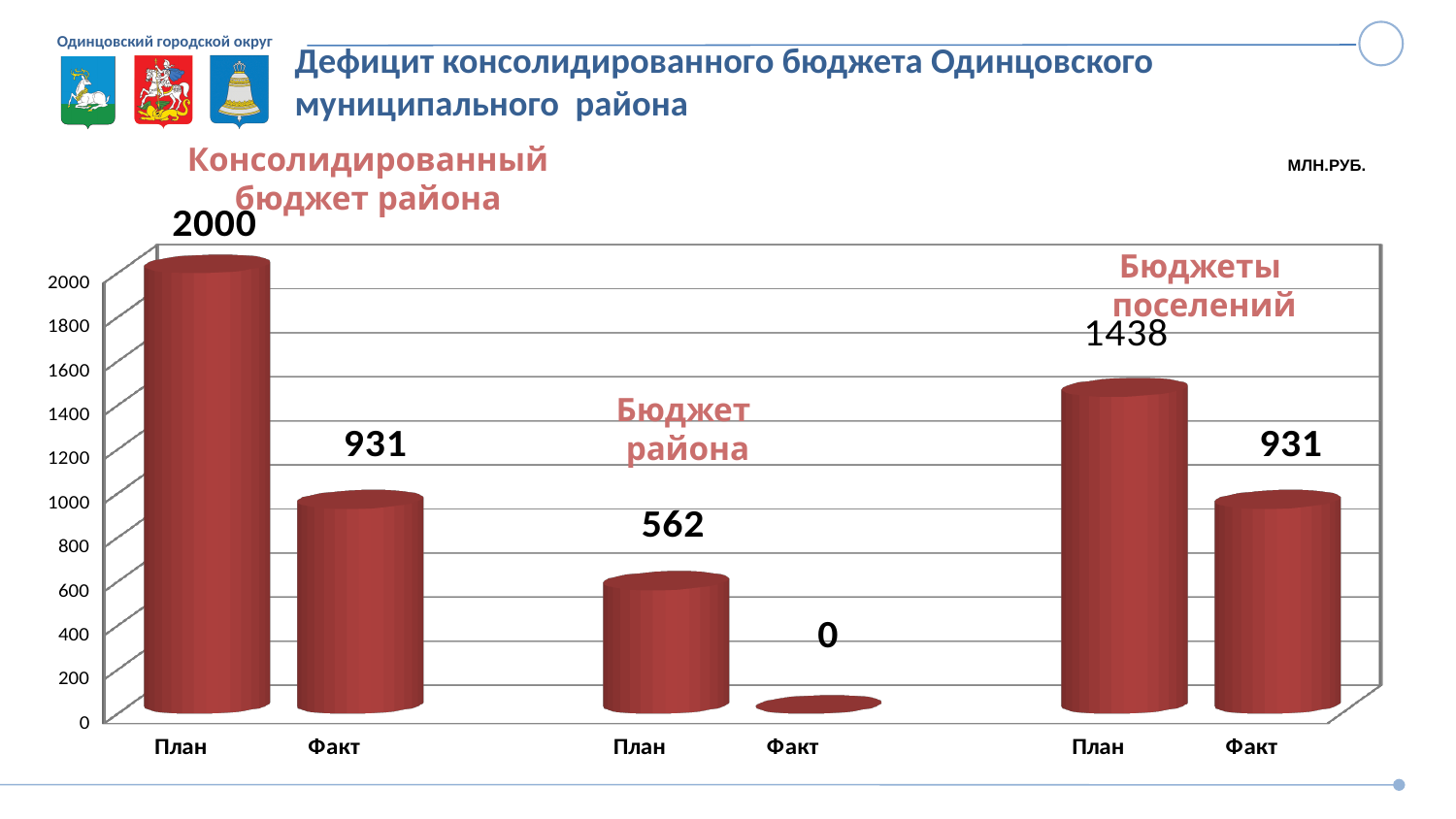
What is the difference between План and Факт for Бюджеты поселений? 507 Which is larger: the План value for Бюджет района or the План value for Бюджеты поселений? План for Бюджеты поселений What is the value of the Факт bar for Бюджеты поселений? 931 Which bar has the lowest value on the chart? Факт for Бюджет района Which bar has the highest value on the chart? План for Консолидированный бюджет района How many bars are plotted on the chart? 6 What is the value of the Факт bar for Бюджет района? 0 What is the value of the План bar for Консолидированный бюджет района? 2000 What unit of measurement is indicated for the chart values? МЛН.РУБ. What is the difference between План and Факт for Консолидированный бюджет района? 1069 What kind of chart is shown on the slide? Bar chart What is the value of the План bar for Бюджеты поселений? 1438